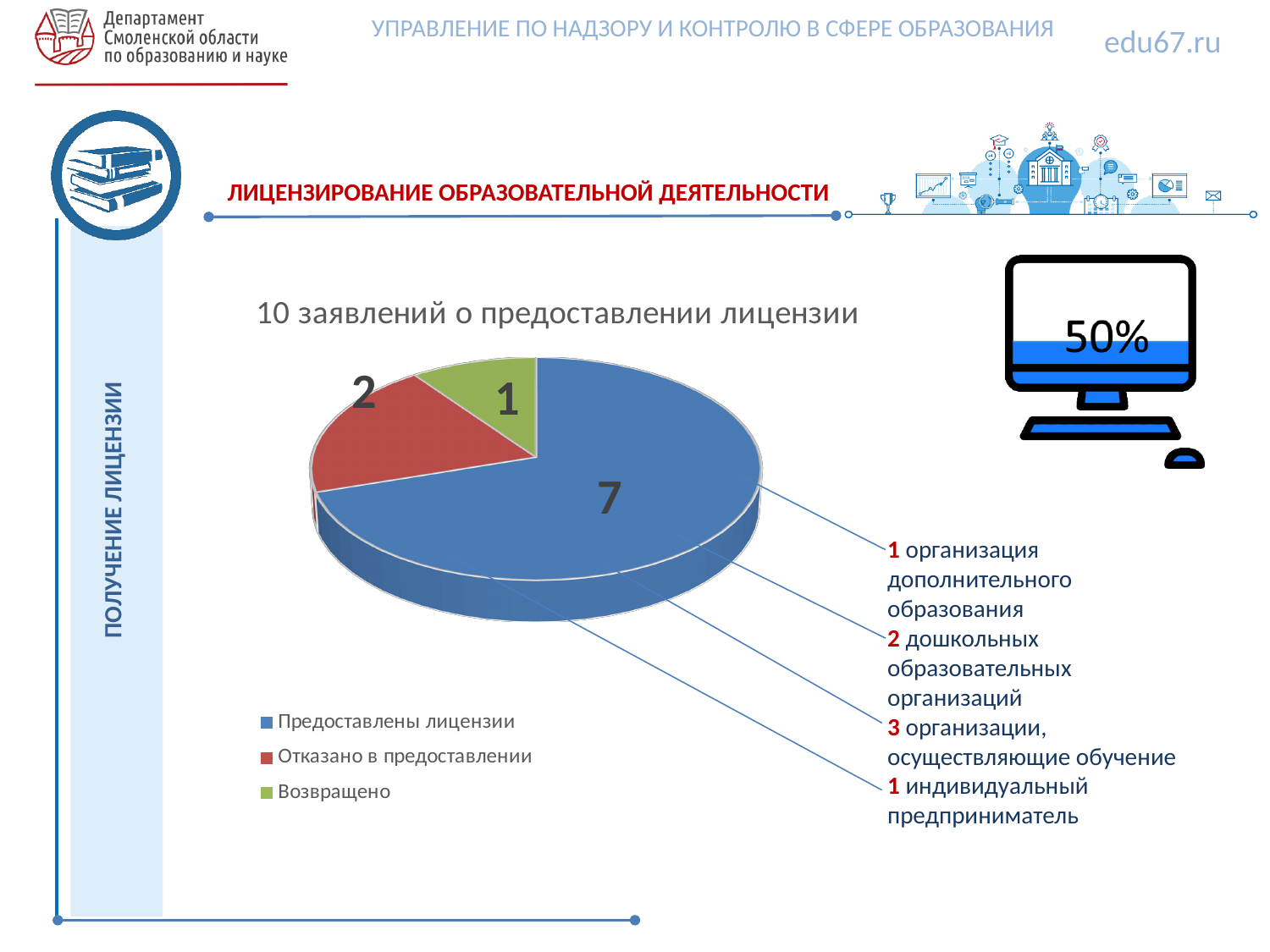
How many entries does the legend of the pie chart list? 3 What is the value for "Возвращено" in the pie chart? 1 Which category has the smallest slice in the pie chart? Возвращено Which is larger: the value for "Отказано в предоставлении" or the value for "Возвращено"? Отказано в предоставлении What is the difference between the values for "Предоставлены лицензии" and "Отказано в предоставлении"? 5 What share of the pie does the "Предоставлены лицензии" slice represent? 70% What is the value for "Предоставлены лицензии" in the pie chart? 7 How many slices does the pie chart have? 3 What type of chart is shown on the slide? Pie chart Which category has the largest slice in the pie chart? Предоставлены лицензии What is the title of the pie chart? 10 заявлений о предоставлении лицензии What is the value for "Отказано в предоставлении" in the pie chart? 2